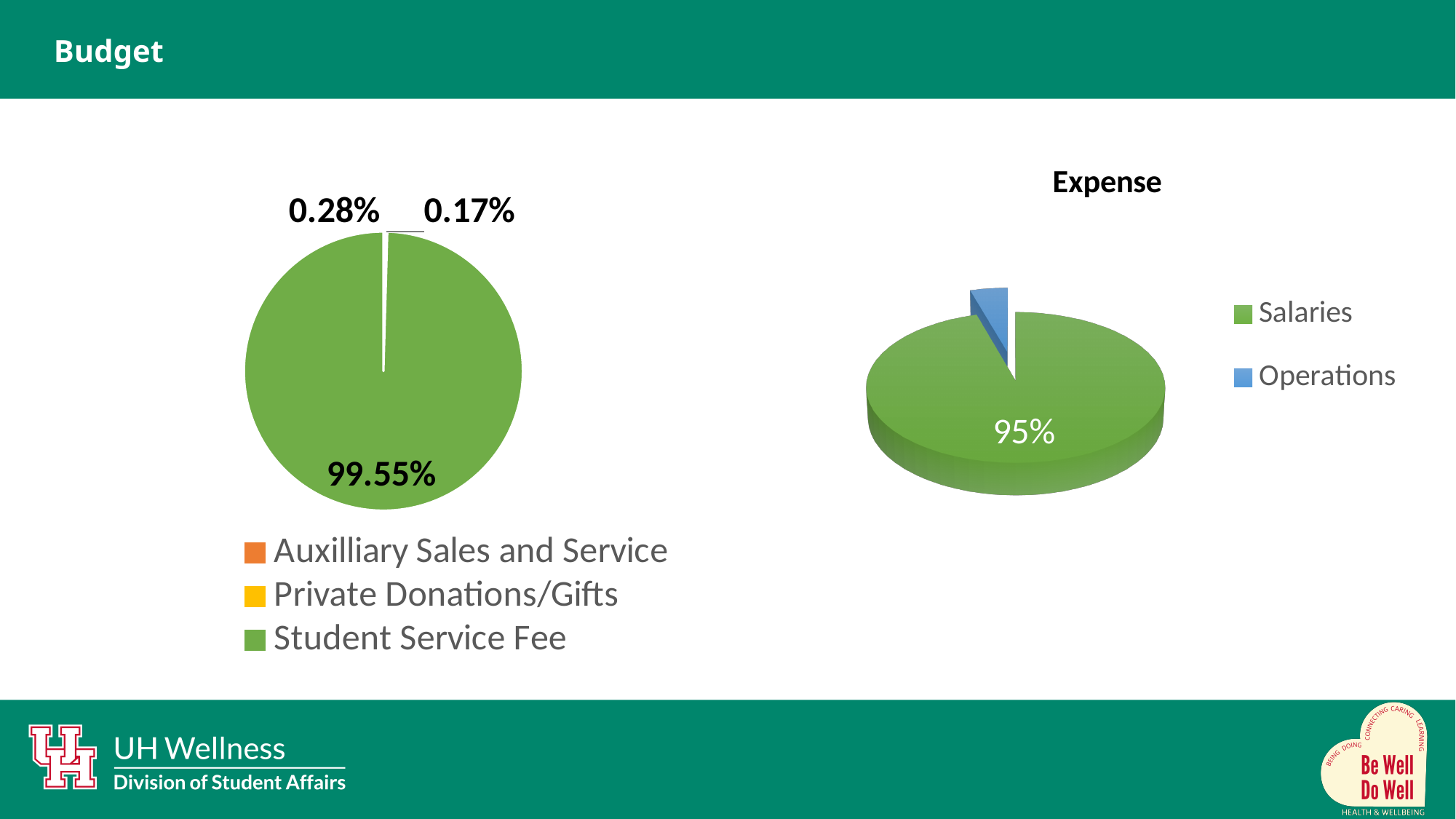
On the Expense chart, which category has the largest share? Salaries How many categories does the legend of the Expense chart list? 2 How many categories does the legend of the left pie chart list? 3 On the Expense chart, which category has the smallest share? Operations On the left pie chart, is the share for Student Service Fee greater or less than 90%? greater On the Expense chart, what percentage is shown for Salaries? 95% On the left pie chart, which category has the largest share? Student Service Fee On the Expense chart, which is larger, Salaries or Operations? Salaries What is the title of the right-hand chart? Expense What kind of chart is the left chart on the slide? Pie chart On the left pie chart, what percentage is shown for Student Service Fee? 99.55% On the Expense chart, what colour is the Operations slice? Blue